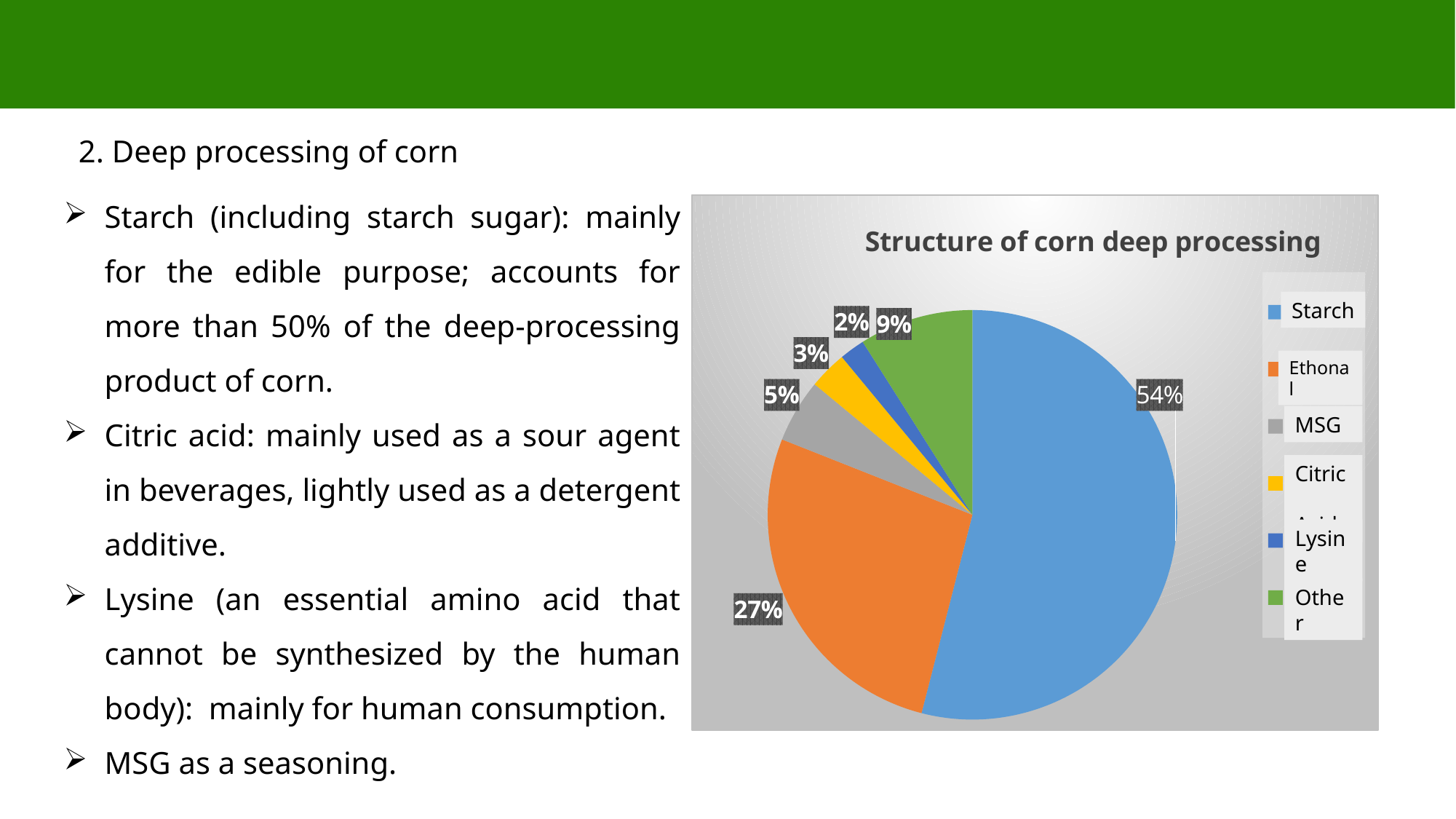
What percentage is shown for Ethonal? 27% How many categories are shown in the pie chart? 6 Which category has the smallest slice of the pie? Lysine Which category has the largest slice of the pie? Starch What kind of chart is shown on the slide? Pie chart Which is larger, the MSG slice or the Other slice? Other What percentage is shown for the Other slice? 9% What percentage is shown for MSG? 5% How many percentage points larger is the Starch slice than the Ethonal slice? 27% What percentage is shown for Lysine? 2% What share of corn deep processing does Starch account for? 54% What is the title of the chart? Structure of corn deep processing